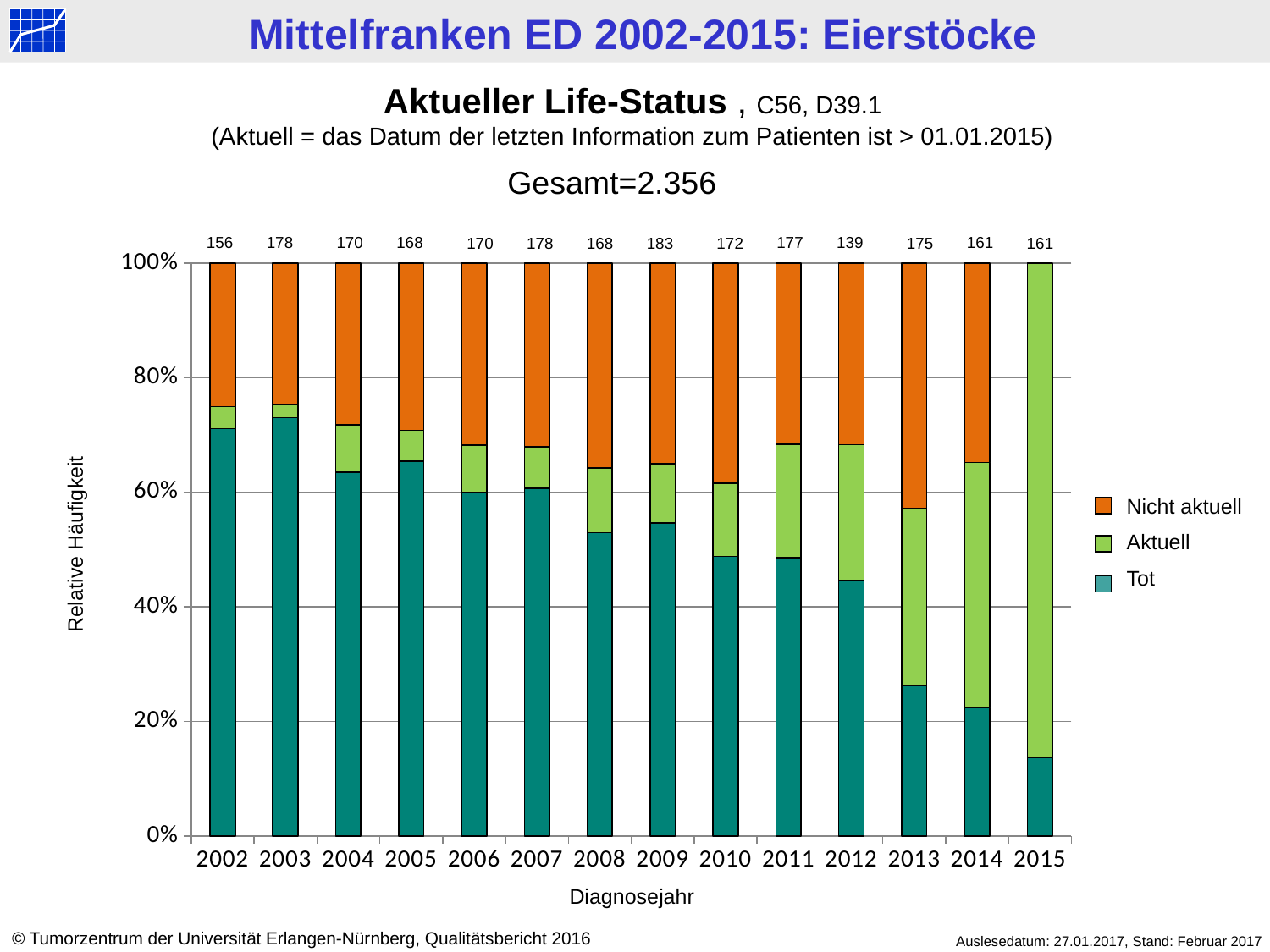
How many series does the legend list? 3 What is the number printed above the bar for 2009? 183 How many diagnosis years are shown on the x axis? 14 What is the difference between the numbers printed above the bars for 2009 and 2012? 44 Which year has the larger number printed above its bar, 2003 or 2004? 2003 What kind of chart is shown on the slide? Stacked bar chart Does the share of 'Tot' generally rise or fall from 2002 to 2015? fall Is the share of 'Tot' in 2002 greater or less than 60%? greater Which diagnosis year has the lowest number printed above its bar? 2012 Is the share of 'Tot' in 2015 greater or less than 20%? less What is the number printed above the bar for 2012? 139 Which diagnosis year has the highest number printed above its bar? 2009